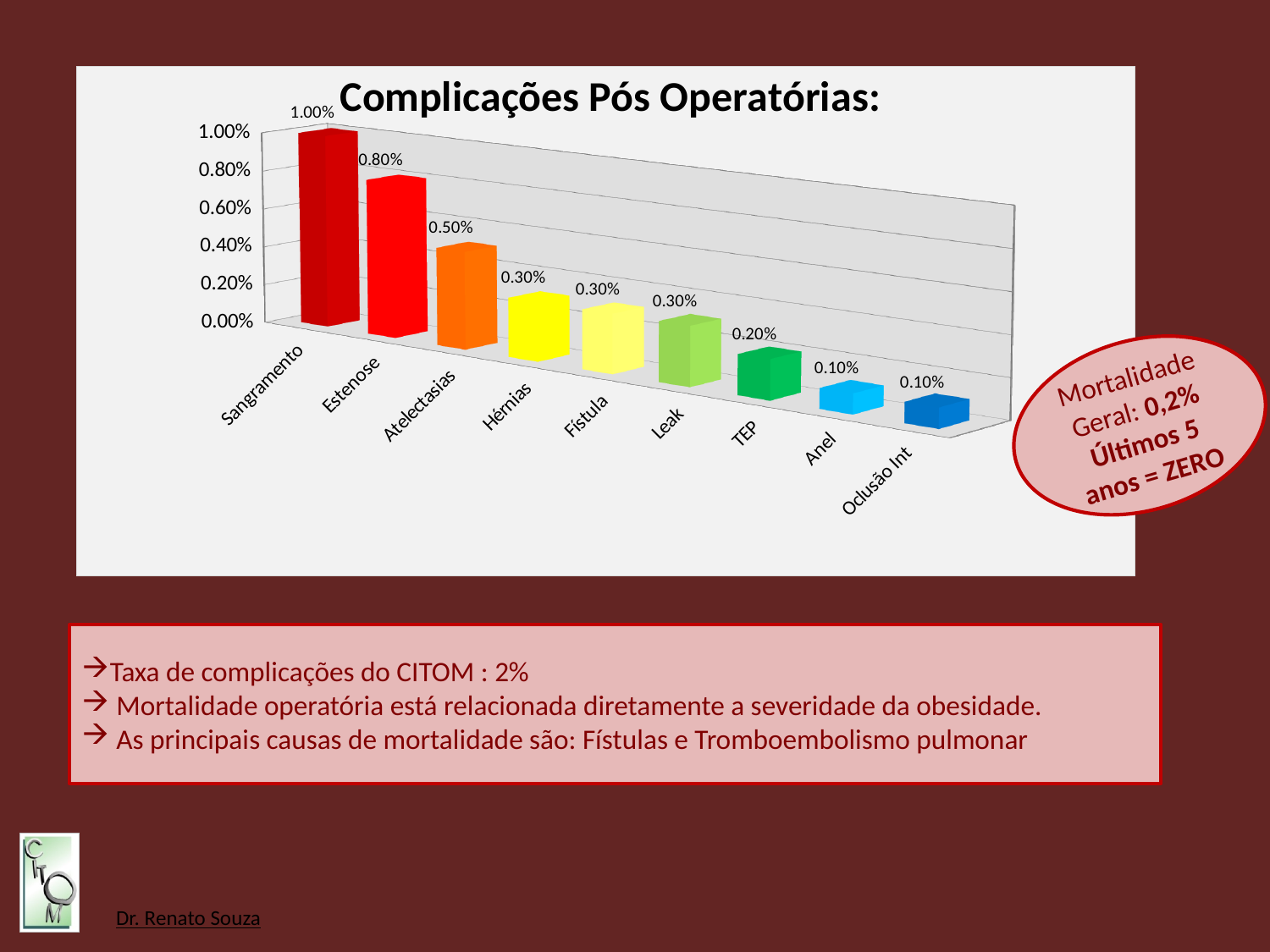
Which is larger, the value for Estenose or the value for Leak? Estenose Is the value for Estenose greater or less than 0.60%? greater What is the difference between the values for Sangramento and Estenose? 0.20% What is the difference between the values for Atelectasias and Anel? 0.40% Which category has the highest value? Sangramento How many categories are shown on the x axis? 9 What is the value for Sangramento? 1.00% Do the values rise or fall from left to right along the x axis? fall What is the value for Atelectasias? 0.50% What is the value for Oclusão Int? 0.10% What kind of chart is shown on the slide? bar chart What is the value for TEP? 0.20%